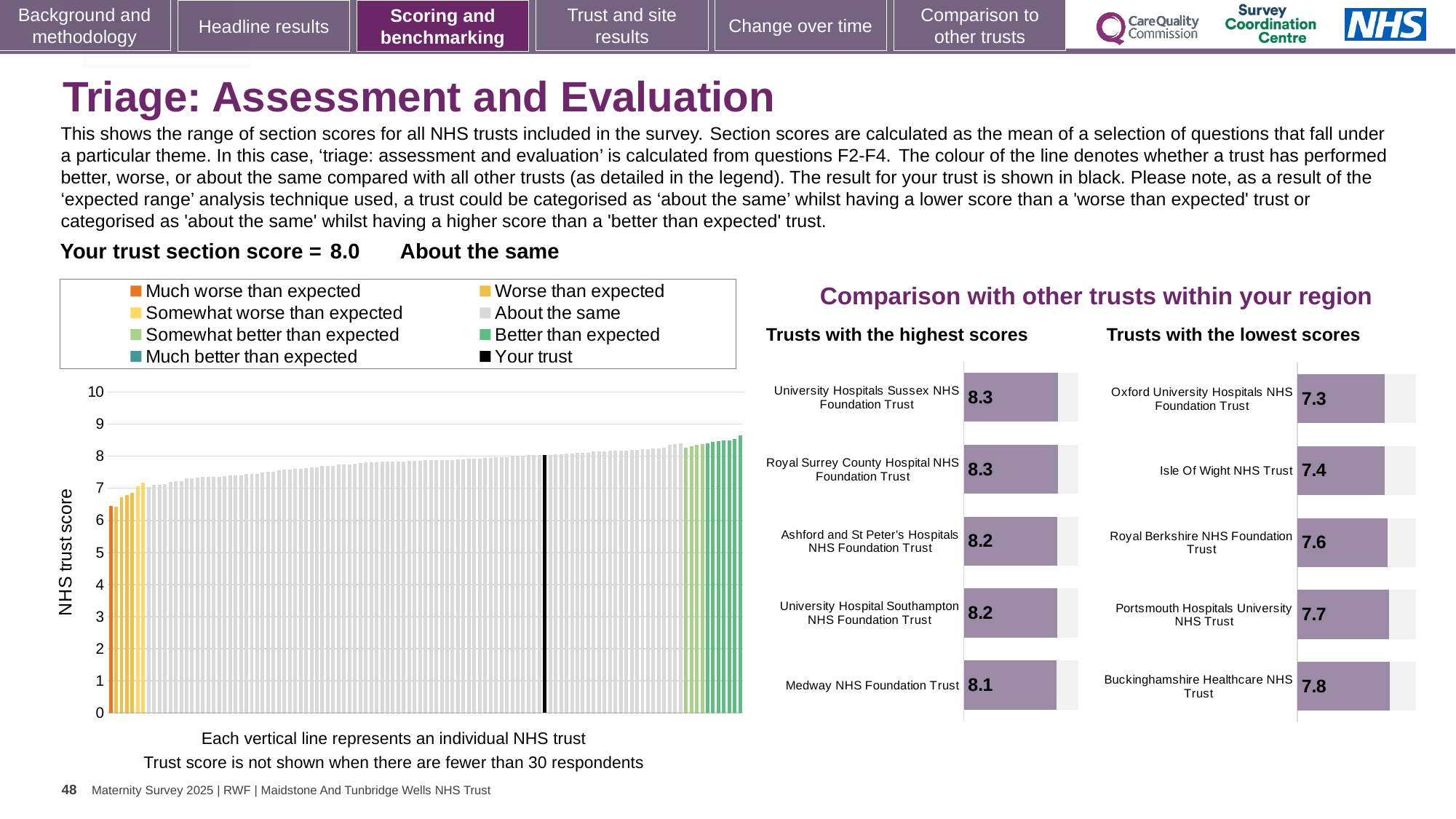
In the 'Trusts with the lowest scores' chart, what is the score for Isle Of Wight NHS Trust? 7.4 In the 'Trusts with the lowest scores' chart, which trust has the highest score? Buckinghamshire Healthcare NHS Trust In the 'Trusts with the lowest scores' chart, which has the higher score: Royal Berkshire NHS Foundation Trust or Portsmouth Hospitals University NHS Trust? Portsmouth Hospitals University NHS Trust In the large chart on the left, is the score of the lowest-scoring trust greater or less than 7? less In the 'Trusts with the lowest scores' chart, what is the difference between the scores of Buckinghamshire Healthcare NHS Trust and Oxford University Hospitals NHS Foundation Trust? 0.5 In the 'Trusts with the lowest scores' chart, which trust has the lowest score? Oxford University Hospitals NHS Foundation Trust How many entries does the legend of the large chart on the left list? 8 In the 'Trusts with the highest scores' chart, what is the score for Medway NHS Foundation Trust? 8.1 In the 'Trusts with the highest scores' chart, which trust has the lowest score? Medway NHS Foundation Trust What kind of chart is the large chart on the left showing NHS trust scores? bar chart How many trusts are shown in the 'Trusts with the highest scores' chart? 5 In the 'Trusts with the highest scores' chart, what is the difference between the scores of University Hospitals Sussex NHS Foundation Trust and Medway NHS Foundation Trust? 0.2